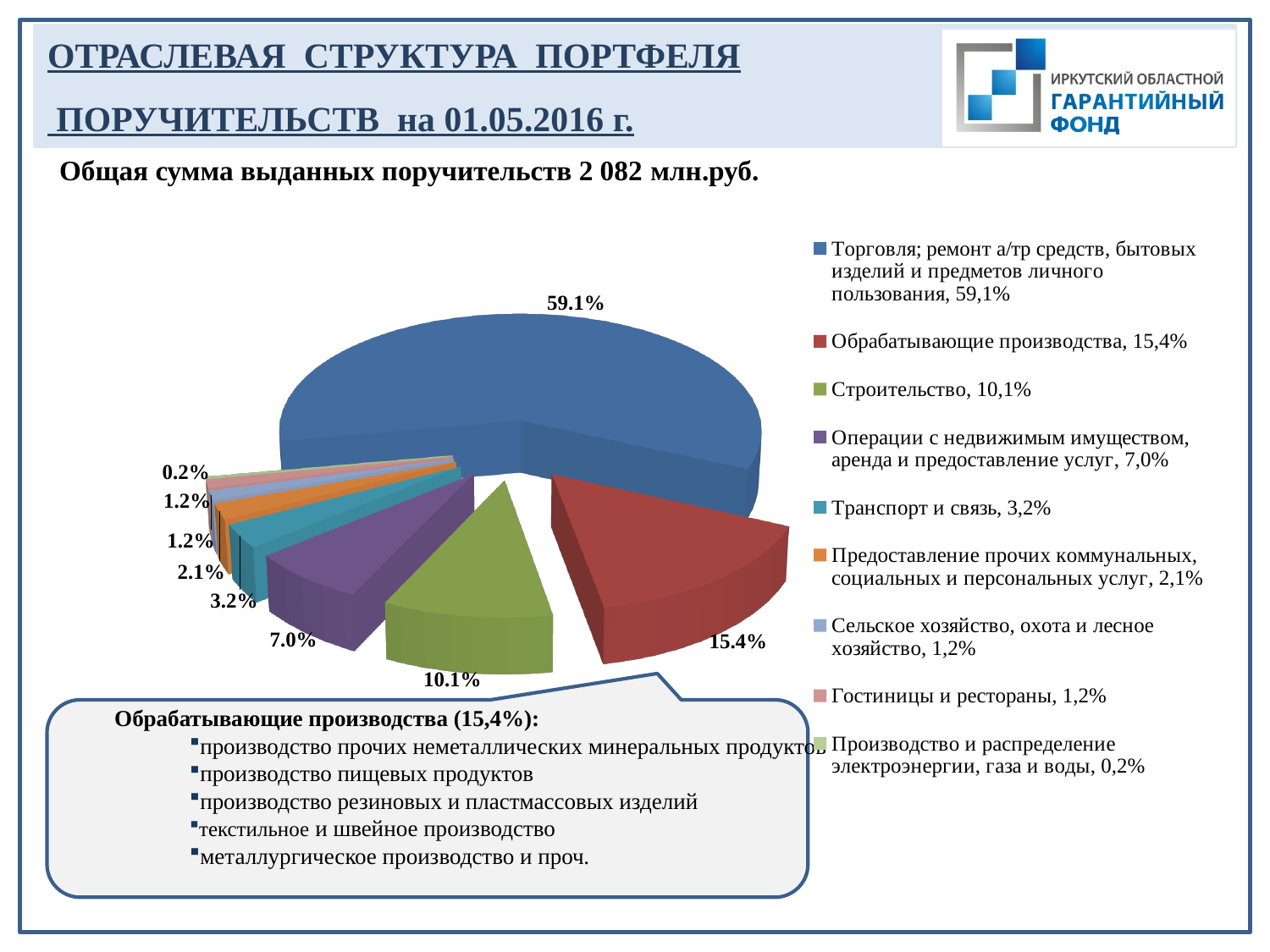
What is the total sum of issued guarantees stated above the chart? 2 082 млн.руб. Which sector has the smallest share of the portfolio? Производство и распределение электроэнергии, газа и воды What share of the portfolio does Производство и распределение электроэнергии, газа и воды hold? 0.2% Which has a larger share: Операции с недвижимым имуществом, аренда и предоставление услуг or Транспорт и связь? Операции с недвижимым имуществом, аренда и предоставление услуг What share of the portfolio does Транспорт и связь hold? 3.2% What is the difference in percentage points between Обрабатывающие производства and Строительство? 5.3 What kind of chart is shown on the slide? pie chart What share of the portfolio does Строительство hold? 10.1% What share of the portfolio does Торговля; ремонт а/тр средств, бытовых изделий и предметов личного пользования hold? 59.1% Which sector has the largest share of the portfolio? Торговля; ремонт а/тр средств, бытовых изделий и предметов личного пользования What share of the portfolio does Обрабатывающие производства hold? 15.4% How many sectors are shown in the pie chart? 9